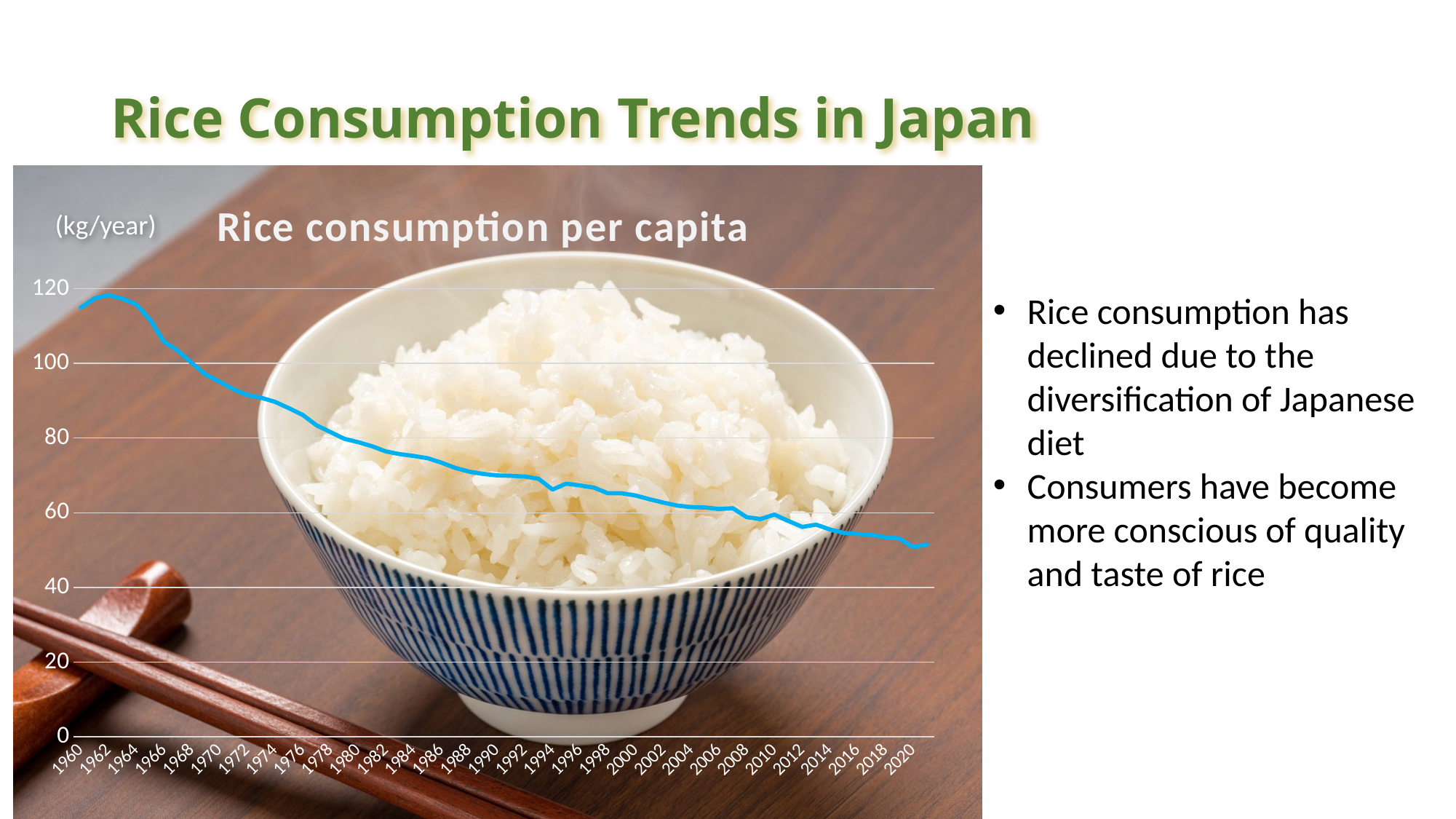
Is the value for 1960 greater or less than 100? greater Which is larger, the value for 1970 or the value for 2000? 1970 What is the title of the chart? Rice consumption per capita What kind of chart is shown on the slide? line chart What unit is shown for the vertical axis of the chart? kg/year Does rice consumption per capita rise or fall from 1960 to 2020? fall Is the value for 2020 greater or less than 60? less Which year has the lowest rice consumption per capita? 2020 Is the value for 2000 greater or less than 80? less What is the highest value shown on the vertical axis? 120